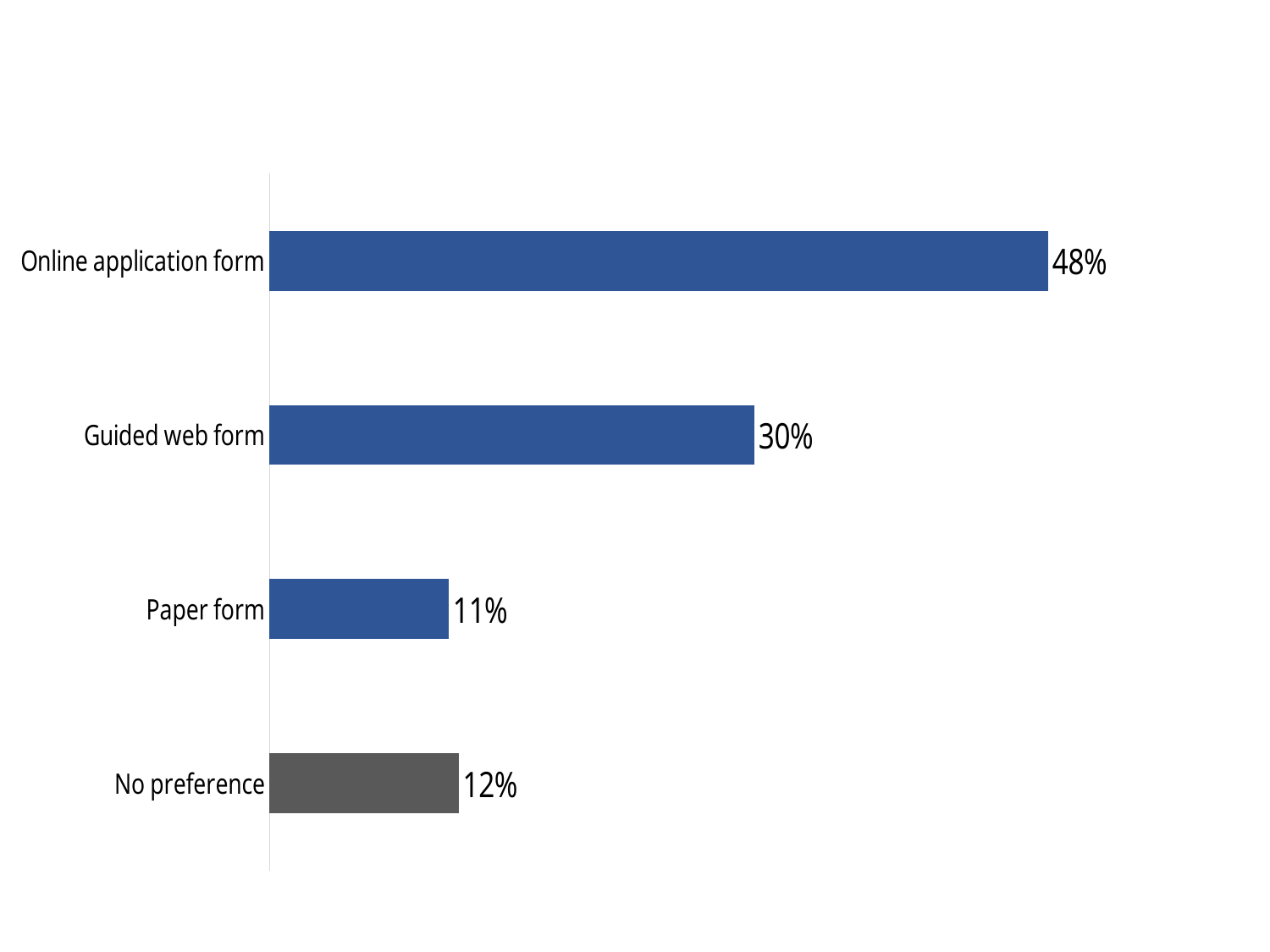
Which category has the highest value? Online application form What is the difference between the values for No preference and Paper form? 1% What kind of chart is shown on the slide? Bar chart Which category has the lowest value? Paper form Which is larger, the value for Guided web form or the value for Paper form? Guided web form What is the difference between the values for Online application form and Guided web form? 18% Which bar is coloured grey rather than blue? No preference How many categories are shown in the chart? 4 What is the value for Guided web form? 30% What is the value for Paper form? 11% What is the value for No preference? 12% What is the value for Online application form? 48%